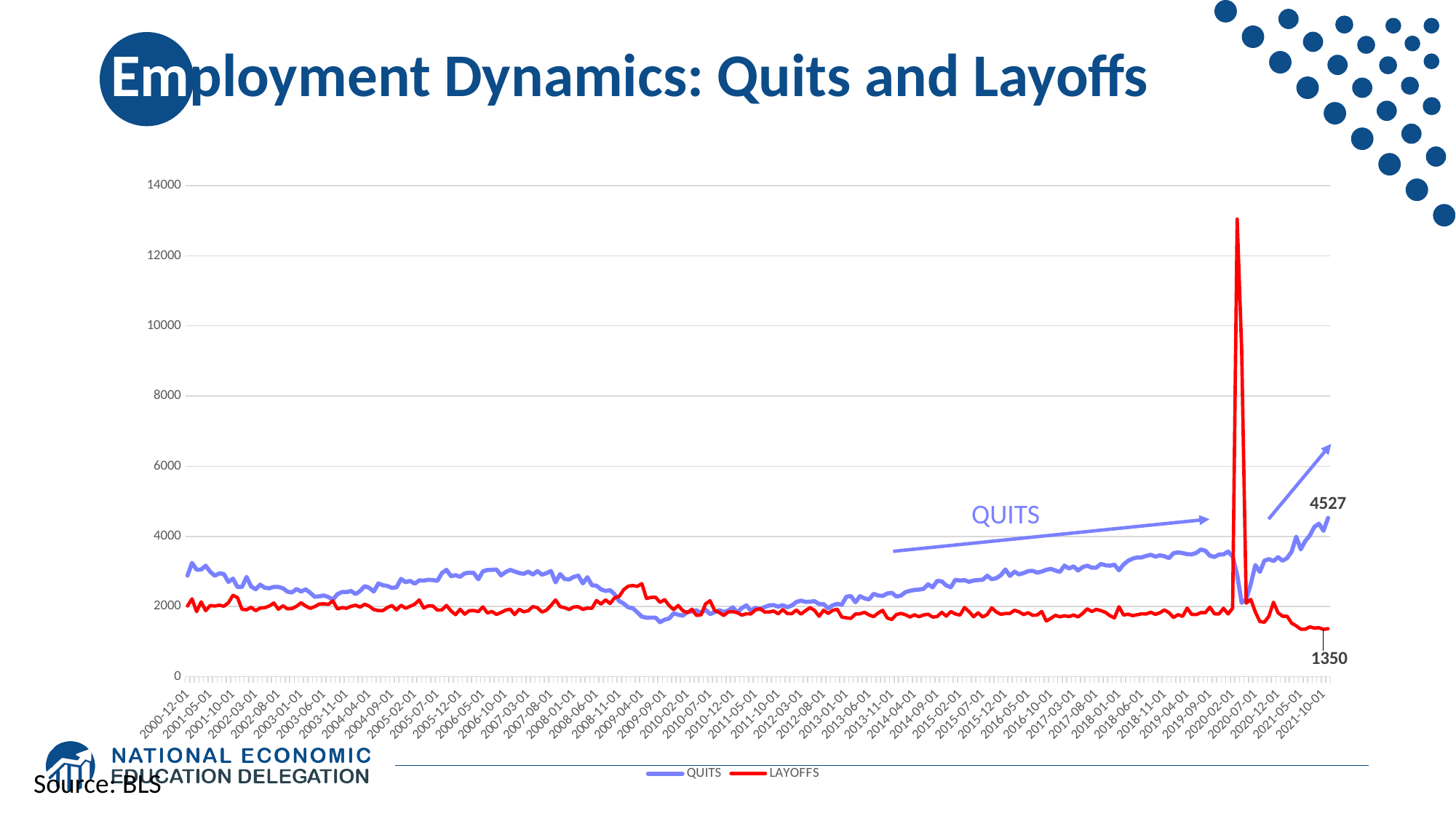
What is the final labelled value of the LAYOFFS series? 1350 How many series does the legend list? 2 At the end of the chart, which series has the larger value, QUITS or LAYOFFS? QUITS Does the QUITS series generally rise or fall between 2013 and 2019? rise What is the final labelled value of the QUITS series? 4527 Which series reaches the highest value anywhere on the chart? LAYOFFS Is the value of the QUITS series around 2009-09-01 greater or less than 2000? less What is the difference between the final labelled QUITS value (4527) and the final labelled LAYOFFS value (1350)? 3177 What kind of chart is shown on the slide? line chart Is the peak value of the LAYOFFS series greater or less than 12000? greater What is the title of the slide? Employment Dynamics: Quits and Layoffs Which colour is used for the LAYOFFS series? red